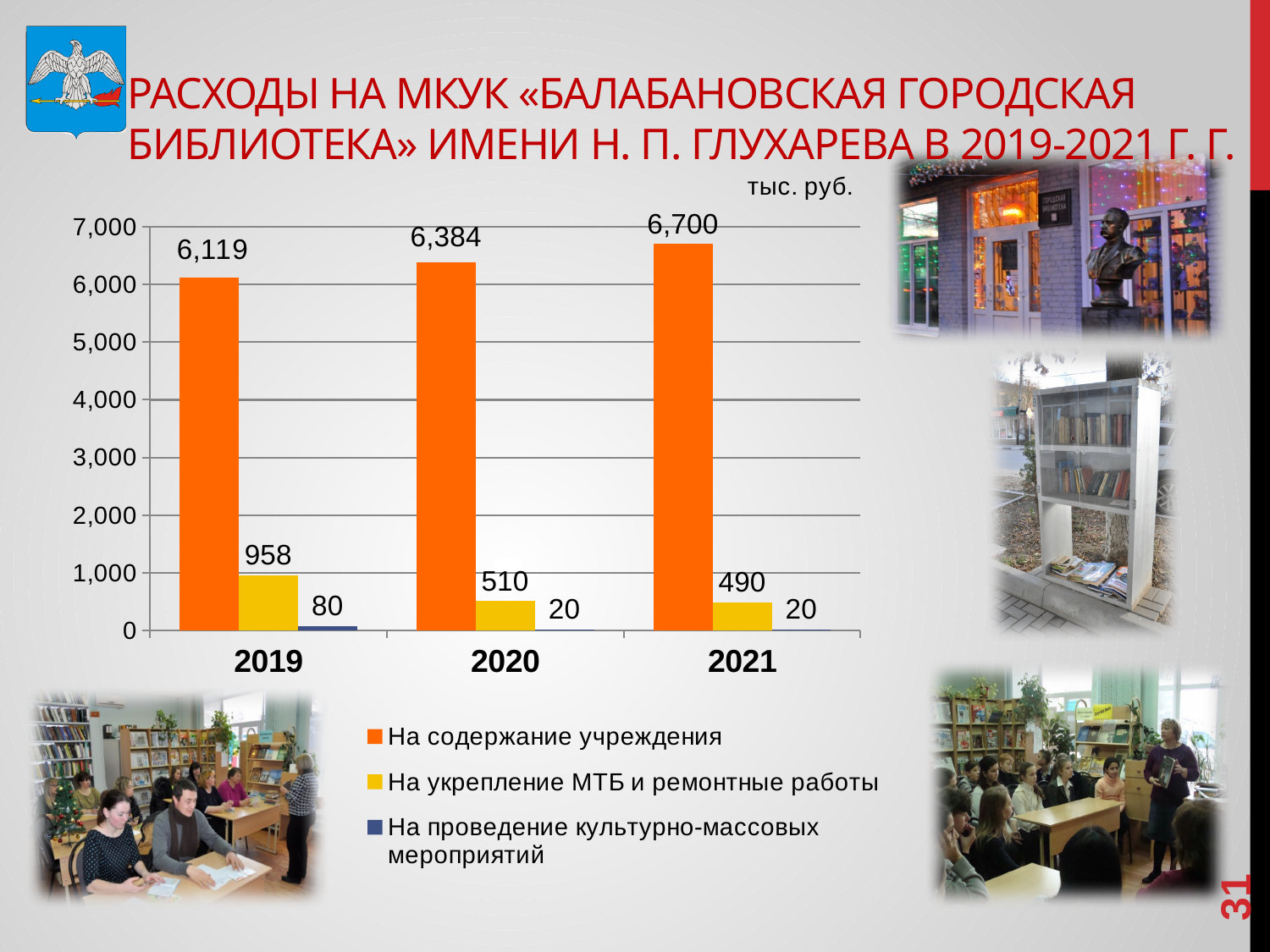
What is the value for "На укрепление МТБ и ремонтные работы" in 2020? 510 In which year is the value for "На укрепление МТБ и ремонтные работы" lowest? 2021 What is the difference between the "На содержание учреждения" values for 2021 and 2019? 581 Does the value for "На содержание учреждения" rise or fall from 2019 to 2021? Rise How many years are shown on the x axis? 3 What is the value for "На содержание учреждения" in 2021? 6,700 What kind of chart is shown on the slide? Bar chart Which is larger: "На укрепление МТБ и ремонтные работы" in 2019 or in 2020? 2019 What is the value for "На проведение культурно-массовых мероприятий" in 2019? 80 How many series does the legend list? 3 In which year is the value for "На содержание учреждения" highest? 2021 What is the value for "На содержание учреждения" in 2019? 6,119